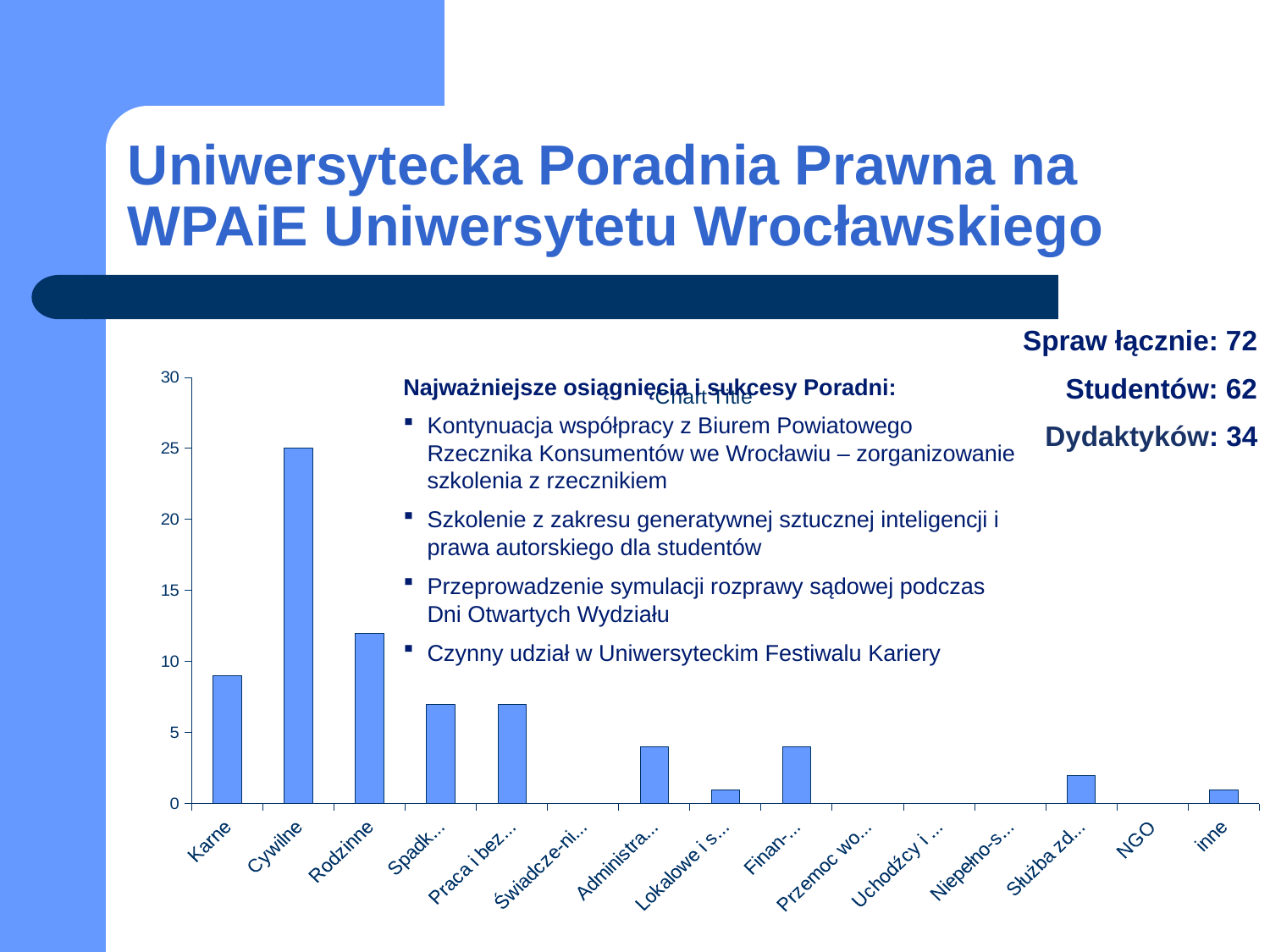
Which category has the highest value in the chart? Cywilne What is the value for Cywilne? 25 What type of chart is shown on the slide? bar chart What is the title shown on the chart? Chart Title Which is larger, the value for Spadk... or the value for Administra...? Spadk... Is the value for Karne greater or less than 10? less How many categories are shown on the x axis of the chart? 15 Is the value for Rodzinne greater or less than 10? greater Is the value for Spadk... greater or less than 10? less Which is larger, the value for Karne or the value for Rodzinne? Rodzinne